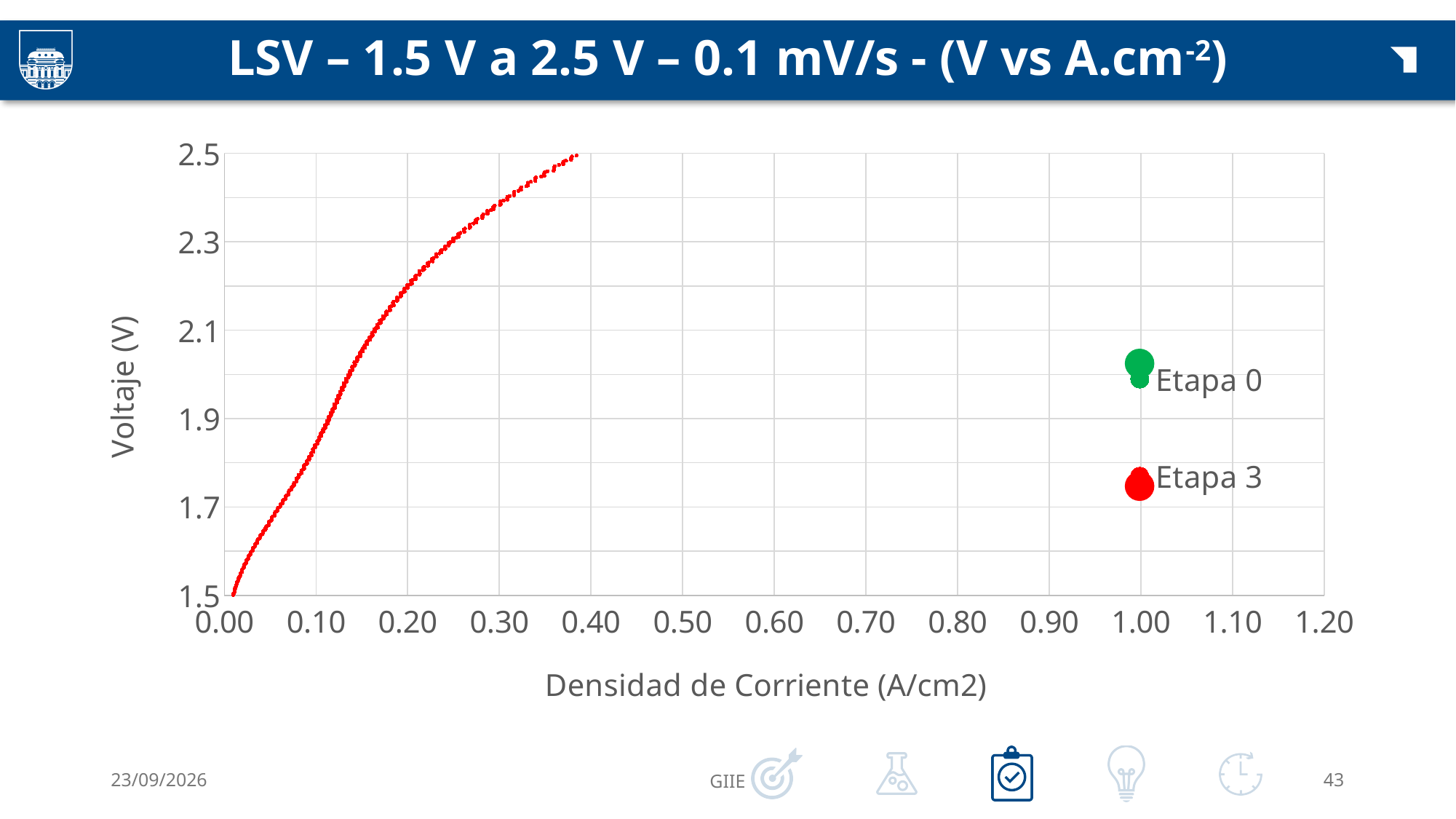
What is the label of the y axis? Voltaje (V) Is the voltage of the Etapa 3 curve at a current density of 0.10 A/cm2 greater or less than 1.9 V? less Does the voltage of the Etapa 3 curve rise or fall as current density increases? rise What is the lowest voltage value on the Etapa 3 curve? 1.5 Is the voltage of the Etapa 3 curve at a current density of 0.20 A/cm2 greater or less than 2.1 V? greater Is the voltage of the Etapa 3 curve at a current density of 0.30 A/cm2 greater or less than 2.3 V? greater What colour is used for the Etapa 3 series? red What kind of chart is shown on the slide? scatter chart What is the highest voltage value reached by the Etapa 3 curve? 2.5 How many series does the legend list? 2 What are the names of the two series in the legend? Etapa 0 and Etapa 3